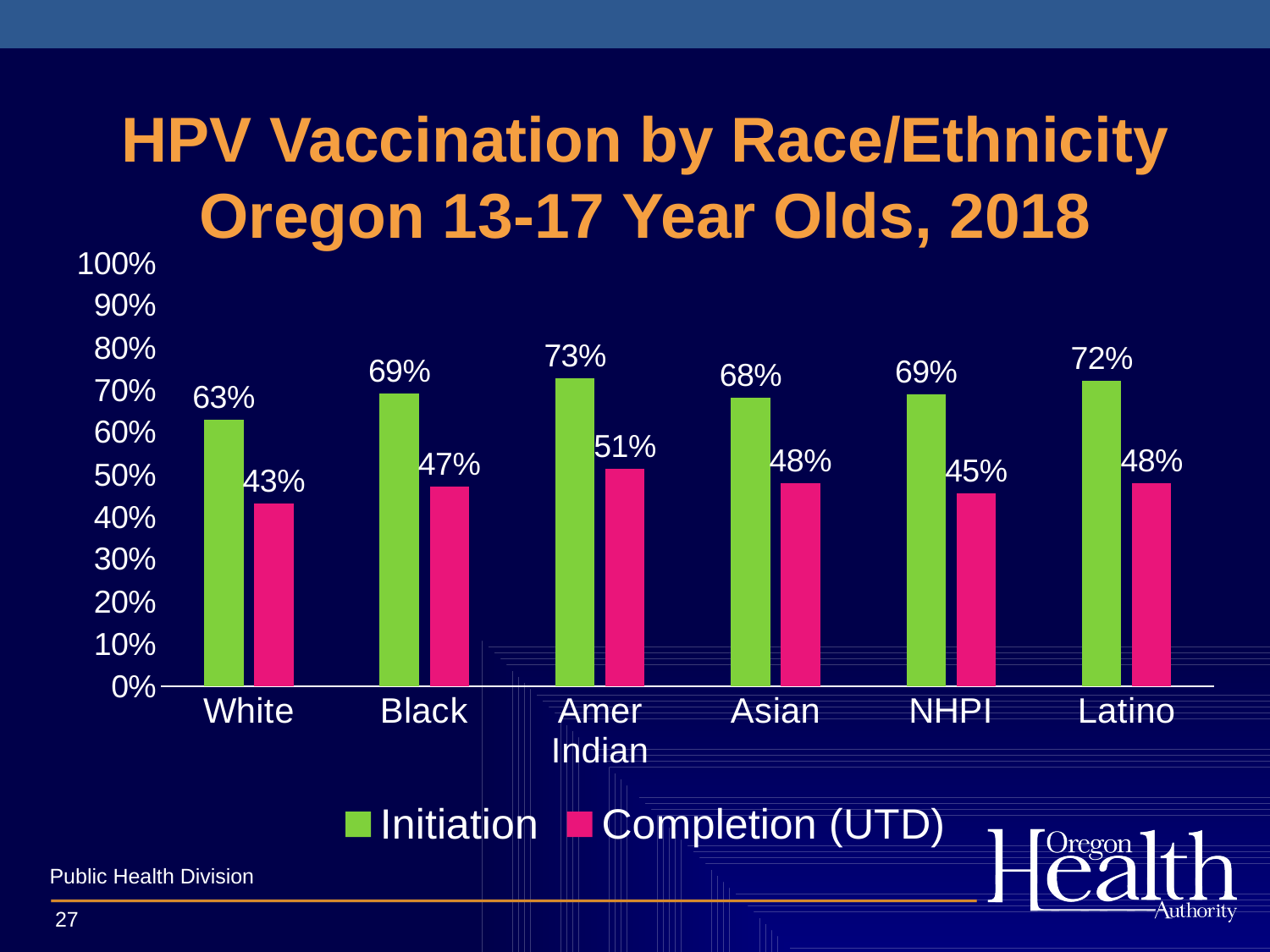
Which colour represents the Completion (UTD) series? Pink Which race/ethnicity group has the highest Initiation value? Amer Indian Which race/ethnicity group has the lowest Completion (UTD) value? White Is the Completion (UTD) value for Amer Indian greater or less than 50%? greater Which is larger, the Initiation value for Black or the Initiation value for Asian? Black What is the Initiation value for Amer Indian? 73% How many race/ethnicity categories are shown on the x axis? 6 How many series does the legend list? 2 What is the Completion (UTD) value for White? 43% What is the difference between the Initiation and Completion (UTD) values for Latino? 24% What kind of chart is shown on the slide? Bar chart What is the Completion (UTD) value for NHPI? 45%